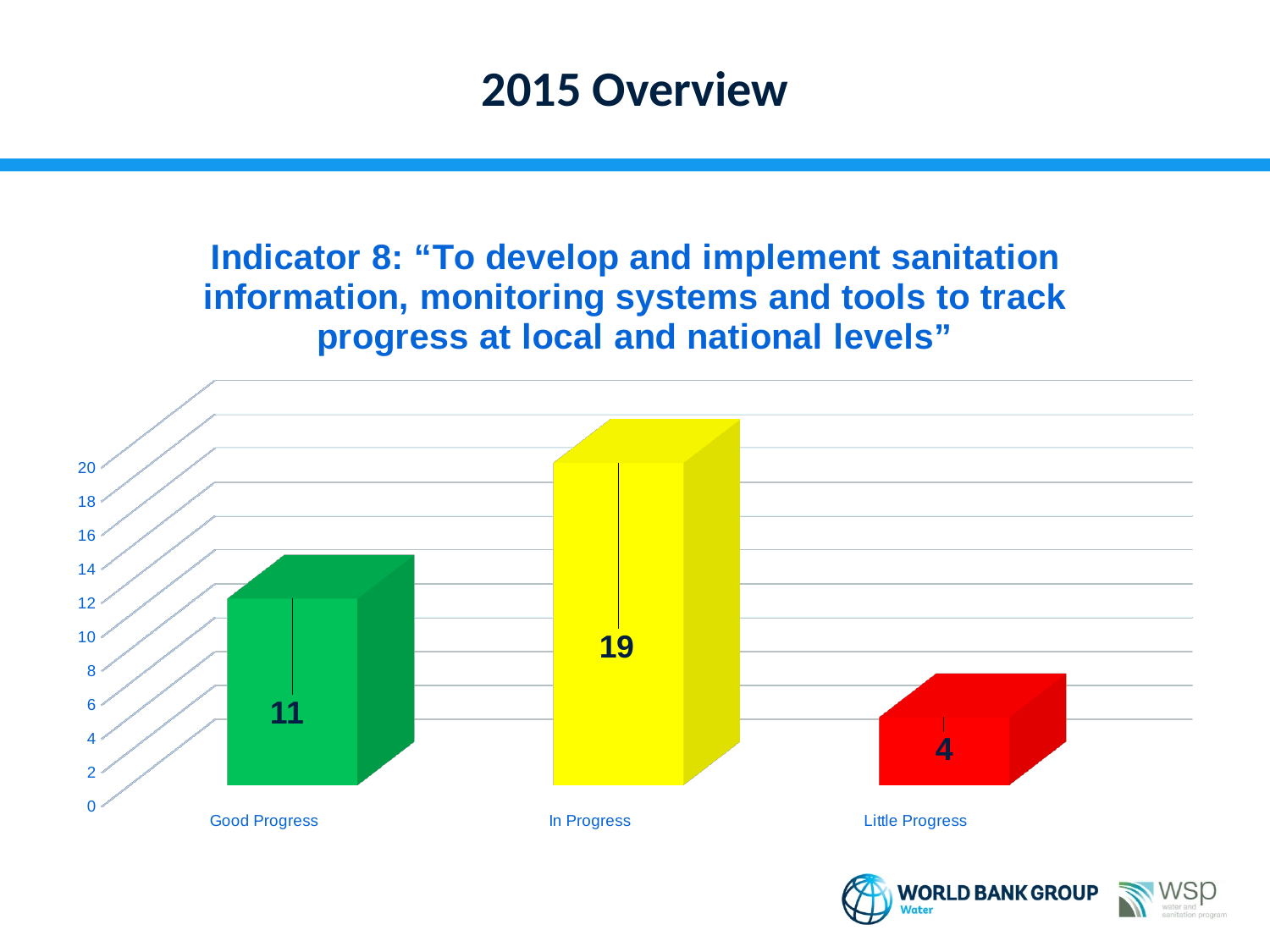
Is the value for In Progress greater or less than 16? greater Which category has the lowest value? Little Progress Which category has the highest value? In Progress What kind of chart is shown on the slide? bar chart What is the difference between the values for Good Progress and Little Progress? 7 What is the difference between the values for In Progress and Good Progress? 8 What is the value for Good Progress? 11 Which is larger, the value for Good Progress or the value for Little Progress? Good Progress What colour is the bar for In Progress? yellow How many categories are shown on the x axis? 3 What is the value for In Progress? 19 What is the value for Little Progress? 4